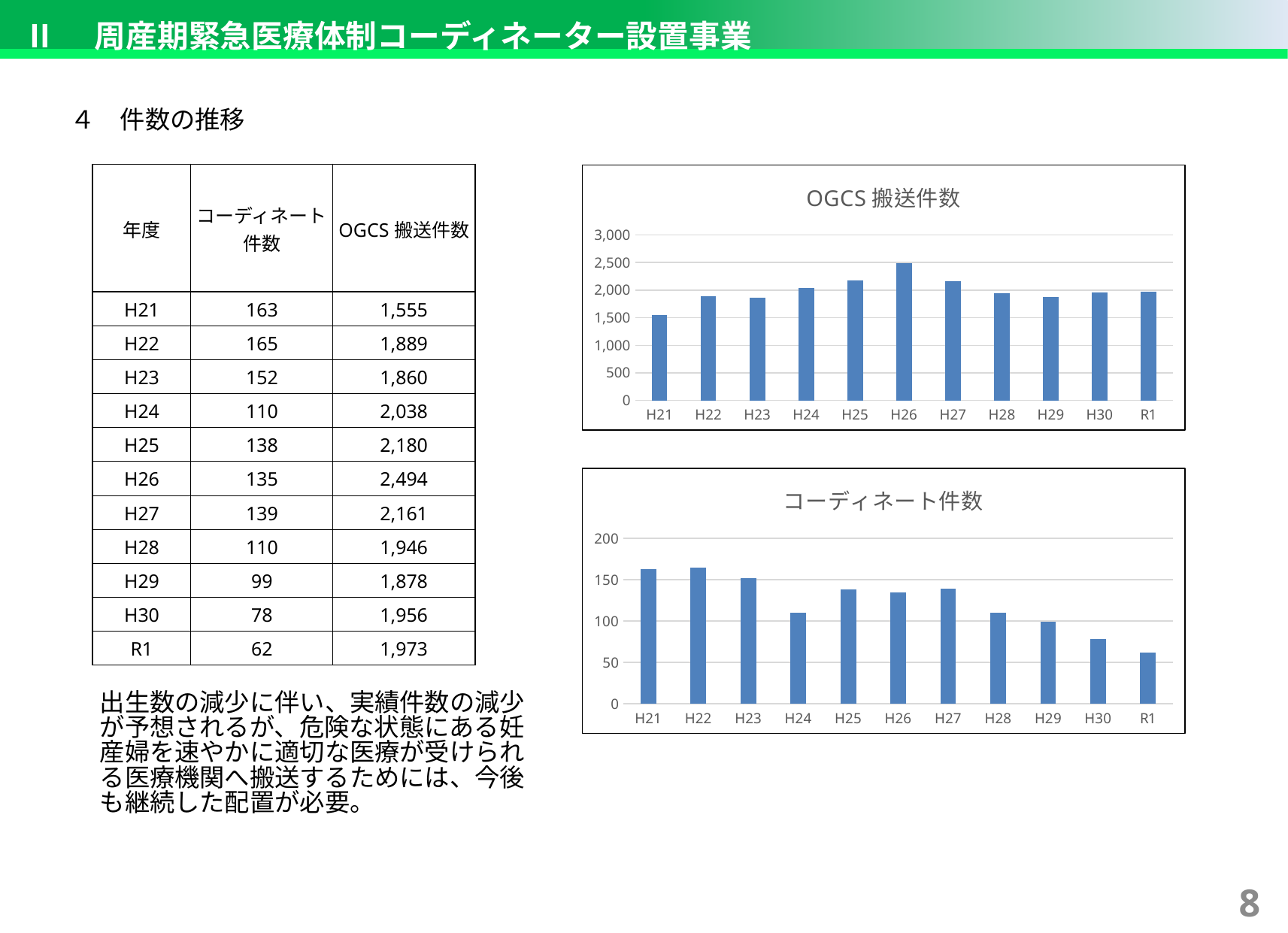
In the OGCS 搬送件数 chart, what is the value for H26? 2,494 In the コーディネート件数 chart, is the value for H22 larger than the value for H24? yes What kind of chart is the コーディネート件数 chart? bar chart In the OGCS 搬送件数 chart, which year has the highest value? H26 In the コーディネート件数 chart, do the values generally rise or fall from H27 to R1? fall In the コーディネート件数 chart, is the value for H30 greater or less than 100? less In the コーディネート件数 chart, which year has the lowest value? R1 In the コーディネート件数 chart, which year has the highest value? H22 How many years are plotted in the OGCS 搬送件数 chart? 11 In the OGCS 搬送件数 chart, is the value for H26 greater or less than 2,000? greater In the OGCS 搬送件数 chart, which year has the lowest value? H21 In the OGCS 搬送件数 chart, is the value for H21 greater or less than 2,000? less